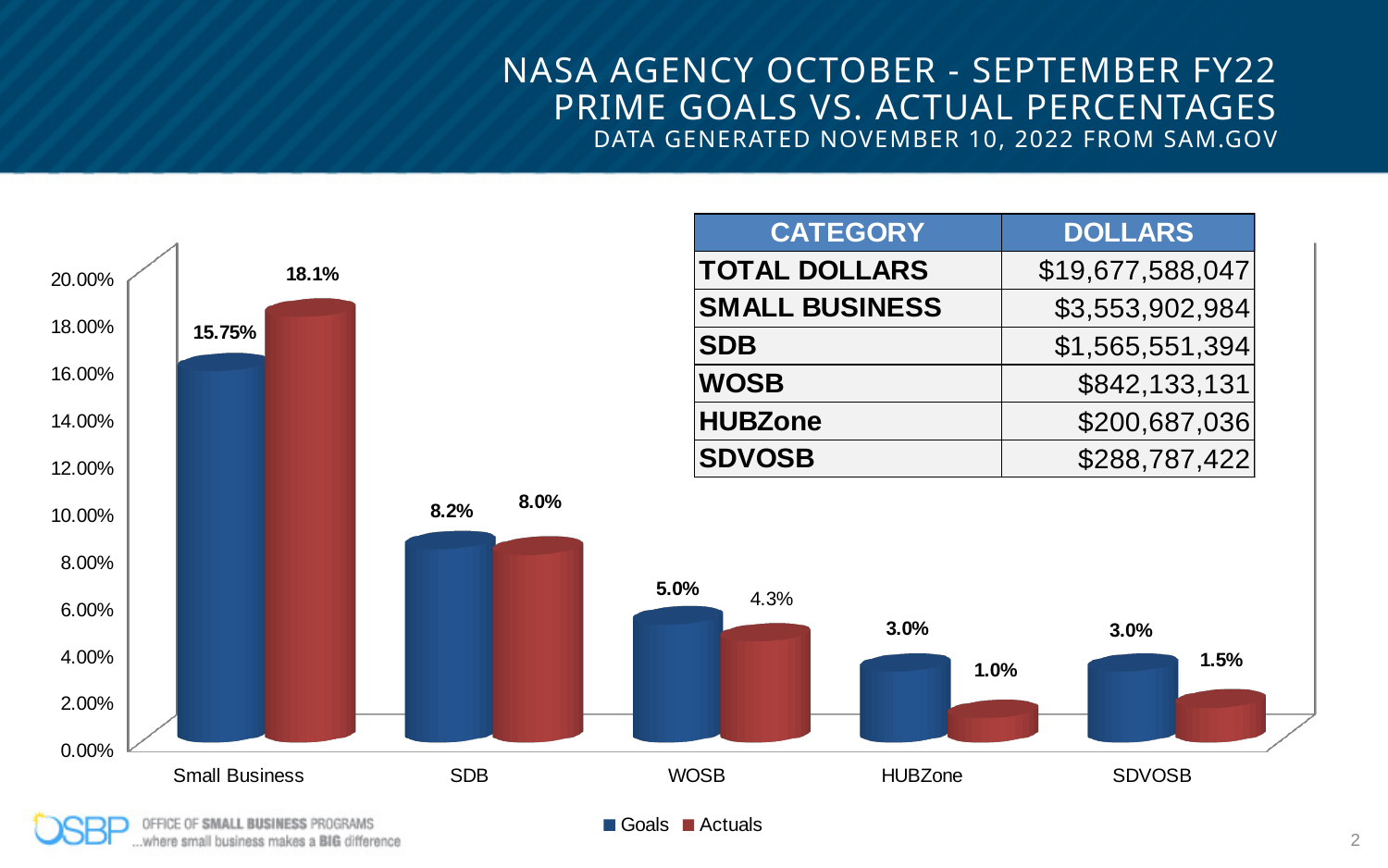
Which category has the highest Actuals value? Small Business Which category has the lowest Actuals value? HUBZone What is the difference between the Goals and Actuals values for HUBZone? 2.0% What is the Actuals value for Small Business? 18.1% What is the Goals value for WOSB? 5.0% What is the Goals value for Small Business? 15.75% How many categories are shown on the x axis of the chart? 5 Which is larger for SDB, the Goals value or the Actuals value? Goals What is the Actuals value for HUBZone? 1.0% What is the Actuals value for SDVOSB? 1.5% How many series does the chart legend list? 2 What is the difference between the Actuals and Goals values for Small Business? 2.35%